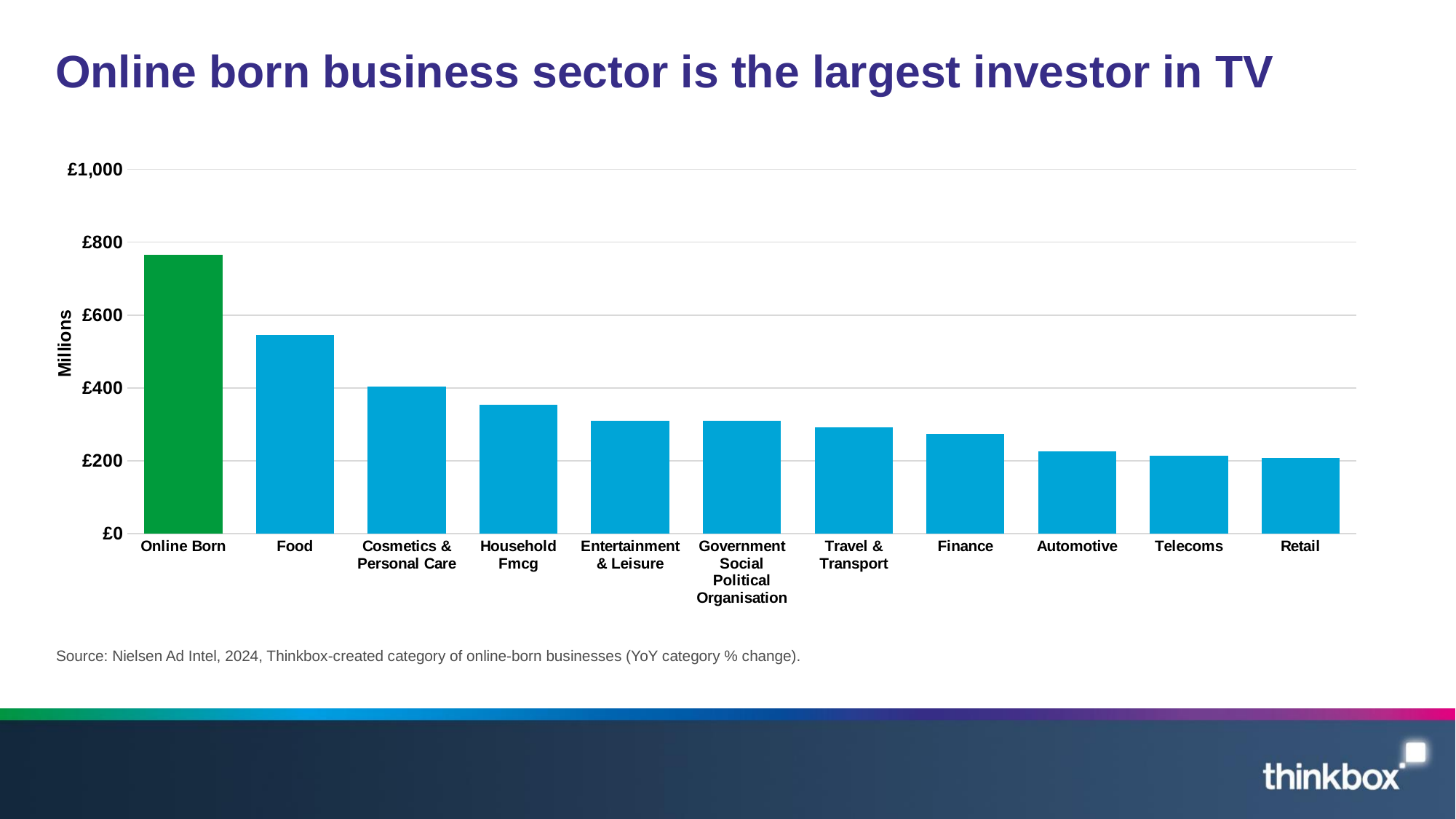
Is the value for Food greater or less than £400? greater How many sectors are shown on the x axis of the chart? 11 Which is larger, the value for Food or the value for Cosmetics & Personal Care? Food Do the bar values rise or fall moving from left to right along the x axis? fall Which sector has the highest TV investment in the chart? Online Born Is the value for Online Born greater or less than £600? greater Is the value for Finance greater or less than £400? less What colour is the Online Born bar? green What kind of chart is shown on the slide? bar chart Which is larger, the value for Online Born or the value for Food? Online Born